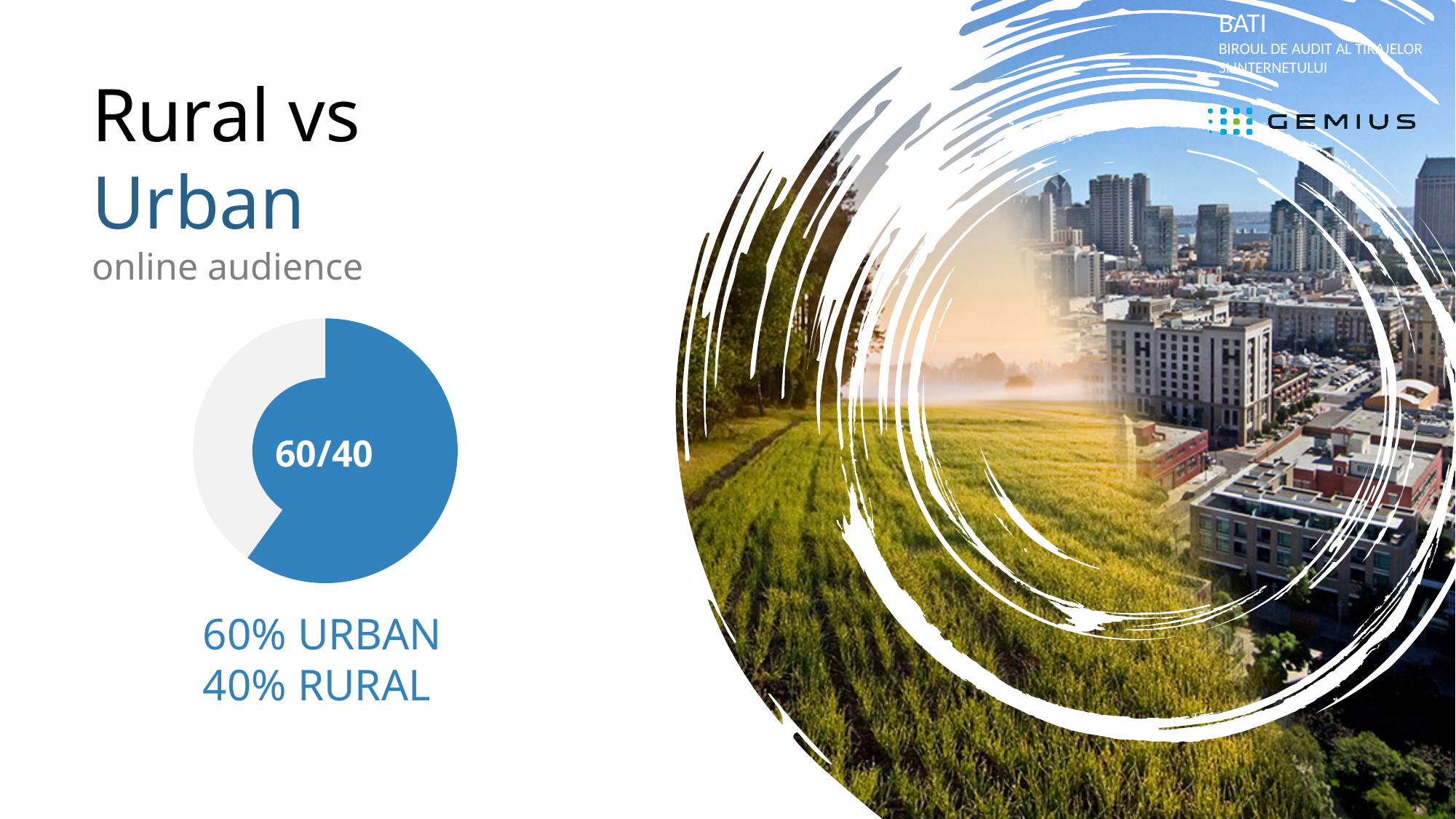
How many categories does the chart show? 2 What ratio is printed in the centre of the chart? 60/40 Which category has the smallest share in the chart? Rural What is the difference in percentage points between the urban and rural shares? 20 percentage points What colour is the urban segment of the chart? Blue Which category has the largest share in the chart? Urban What share of the online audience is rural according to the chart? 40% What share of the online audience is urban according to the chart? 60% What kind of chart is shown on the slide? Pie chart (doughnut) Which segment is larger in the chart, urban or rural? Urban Is the urban share greater or less than 50%? greater